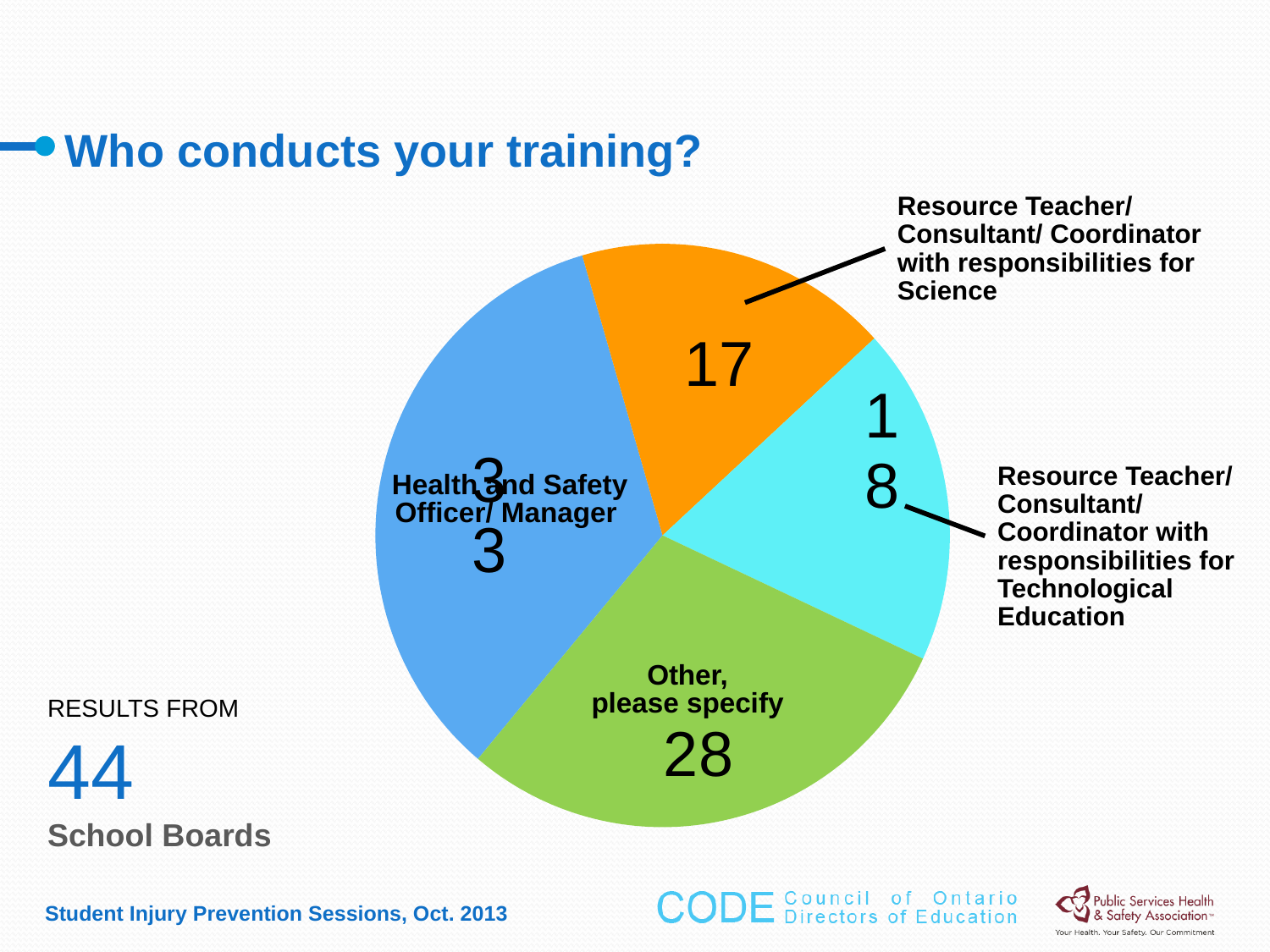
What is the value for the "Health and Safety Officer/ Manager" slice? 33 Which category has the largest slice of the pie? Health and Safety Officer/ Manager What is the value for the "Other, please specify" slice? 28 What is the title of the slide containing the pie chart? Who conducts your training? How many slices does the pie chart have? 4 What is the difference between the "Other, please specify" value and the Science resource teacher value? 11 What colour is the "Other, please specify" slice? Green What kind of chart is shown on the slide? Pie chart Which is larger: the "Other, please specify" slice or the "Health and Safety Officer/ Manager" slice? Health and Safety Officer/ Manager Which category has the smallest slice of the pie? Resource Teacher/ Consultant/ Coordinator with responsibilities for Science What is the value for the "Resource Teacher/ Consultant/ Coordinator with responsibilities for Science" slice? 17 What is the value for the "Resource Teacher/ Consultant/ Coordinator with responsibilities for Technological Education" slice? 18